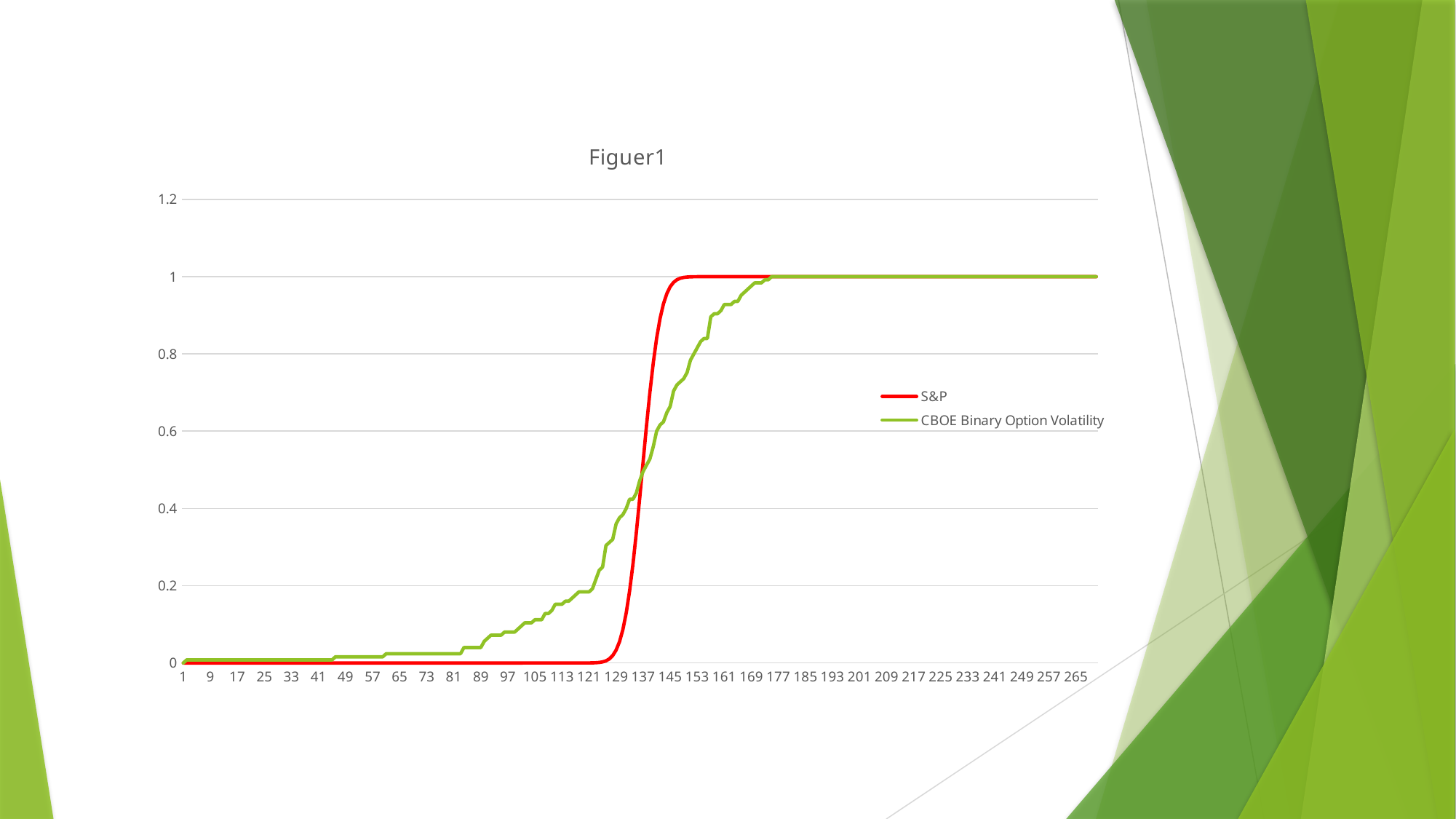
At x = 145, which series has the higher value, S&P or CBOE Binary Option Volatility? S&P Which colour is used for the S&P series? red At x = 121, which series has the higher value, S&P or CBOE Binary Option Volatility? CBOE Binary Option Volatility Is the value of the CBOE Binary Option Volatility series at x = 161 greater or less than 0.8? greater Is the value of the S&P series at x = 137 greater or less than 0.2? greater What kind of chart is shown on the slide? line chart Is the value of the CBOE Binary Option Volatility series at x = 129 greater or less than 0.6? less Do the values of the S&P series rise or fall along the x axis? rise What is the title of the chart? Figuer1 What is the value of the S&P series at x = 265? 1 How many series does the legend list? 2